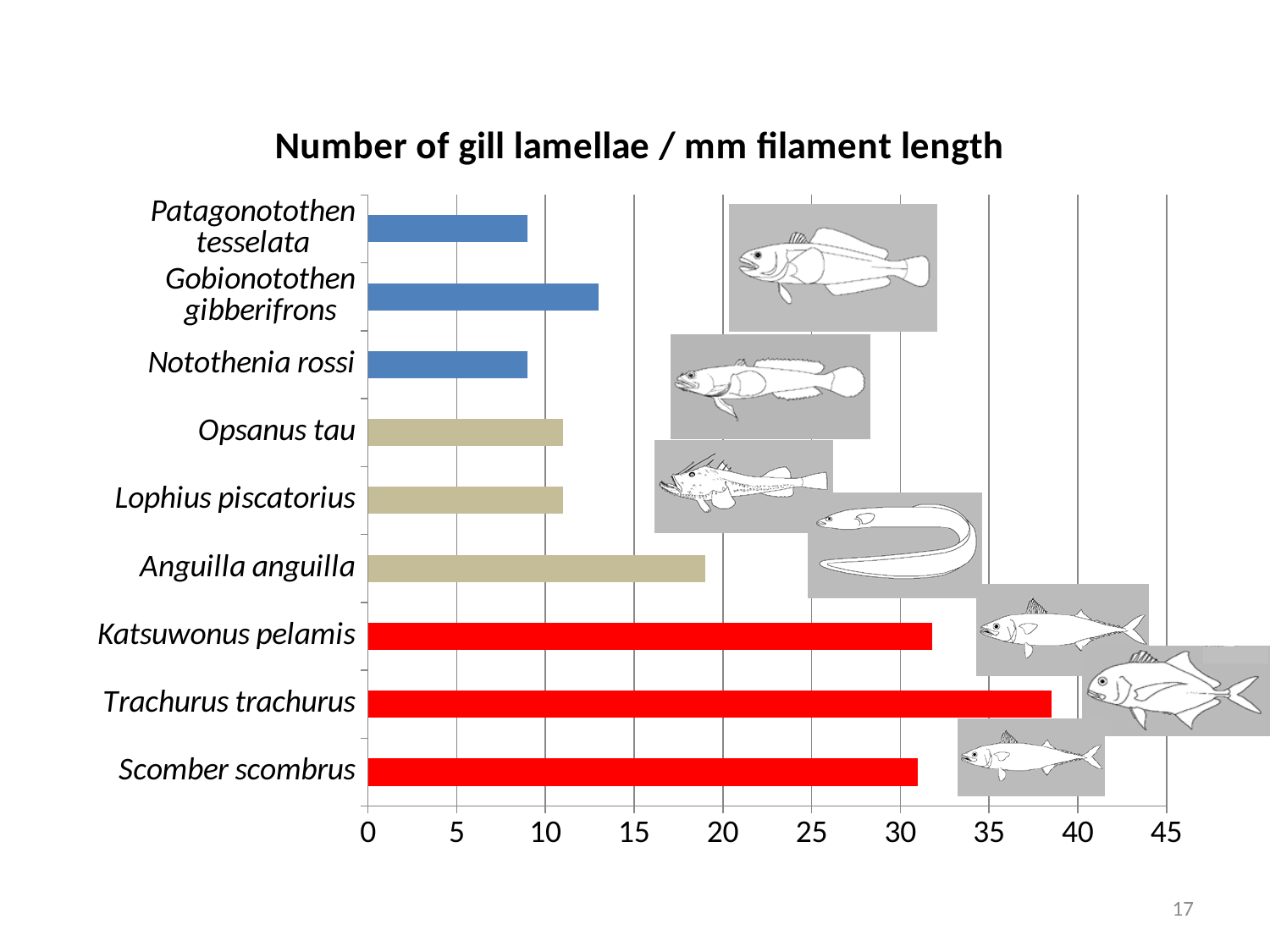
Is the value for Gobionotothen gibberifrons greater or less than 15? less How many fish species are plotted in the chart? 9 Which has the larger value, Anguilla anguilla or Opsanus tau? Anguilla anguilla Which species has the highest number of gill lamellae per mm filament length? Trachurus trachurus Is the value for Scomber scombrus greater or less than 25? greater Is the value for Katsuwonus pelamis greater or less than 30? greater What is the title of the chart? Number of gill lamellae / mm filament length What kind of chart is shown on the slide? bar chart Which has the larger value, Trachurus trachurus or Katsuwonus pelamis? Trachurus trachurus